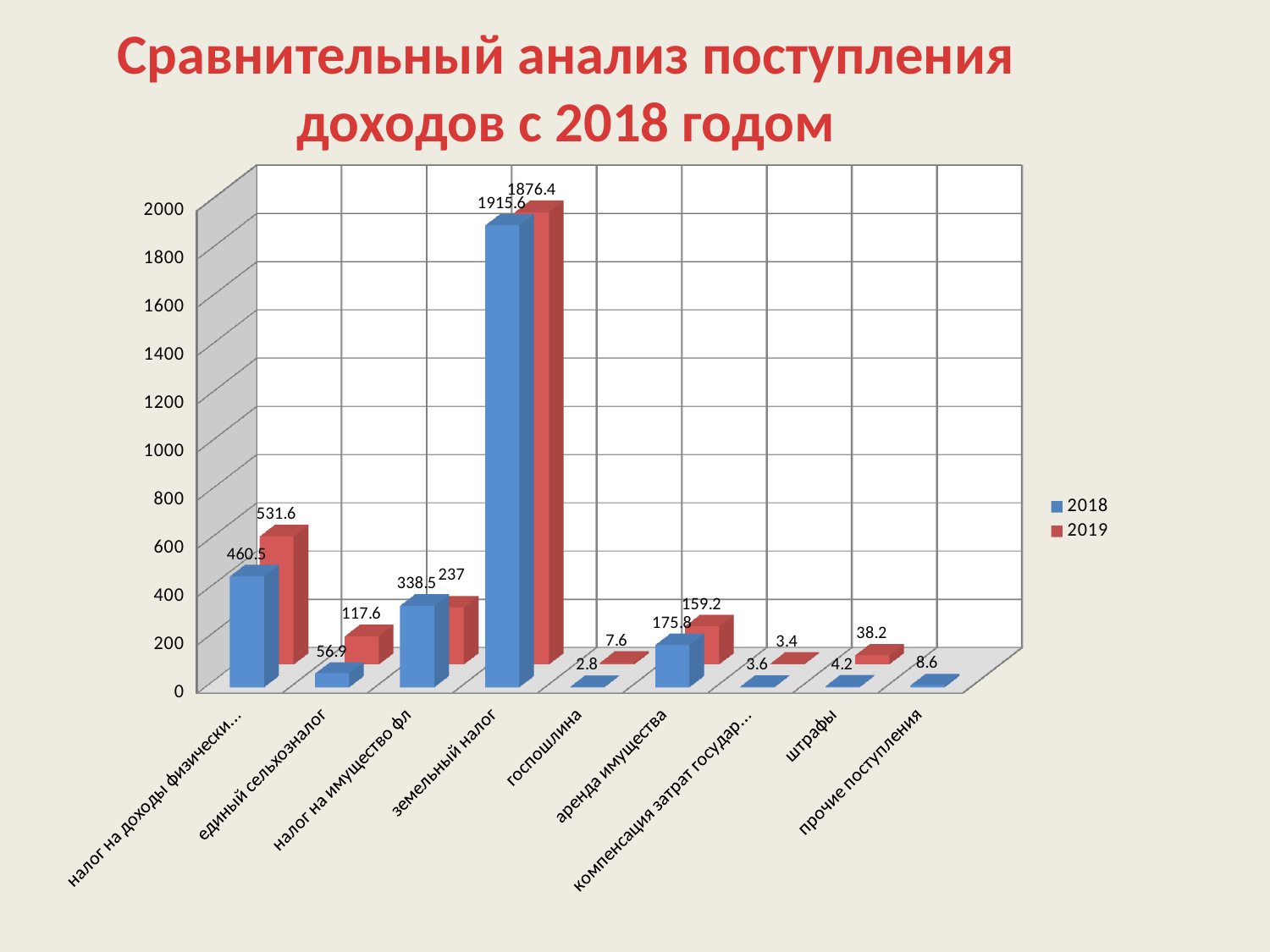
What is the value for штрафы in the 2019 series? 38.2 What is the difference between the 2019 and 2018 values for штрафы? 34 What is the difference between the 2018 and 2019 values for налог на имущество фл? 101.5 Which category has the lowest value in the 2018 series? госпошлина What kind of chart is shown on the slide? bar chart What is the value for земельный налог in the 2019 series? 1876.4 Which category has the highest value in the 2018 series? земельный налог Is the 2018 value for земельный налог greater or less than 1800? greater How many categories are shown on the x axis? 9 What is the value for единый сельхозналог in the 2018 series? 56.9 For аренда имущества, which series has the larger value, 2018 or 2019? 2018 How many series does the legend list? 2